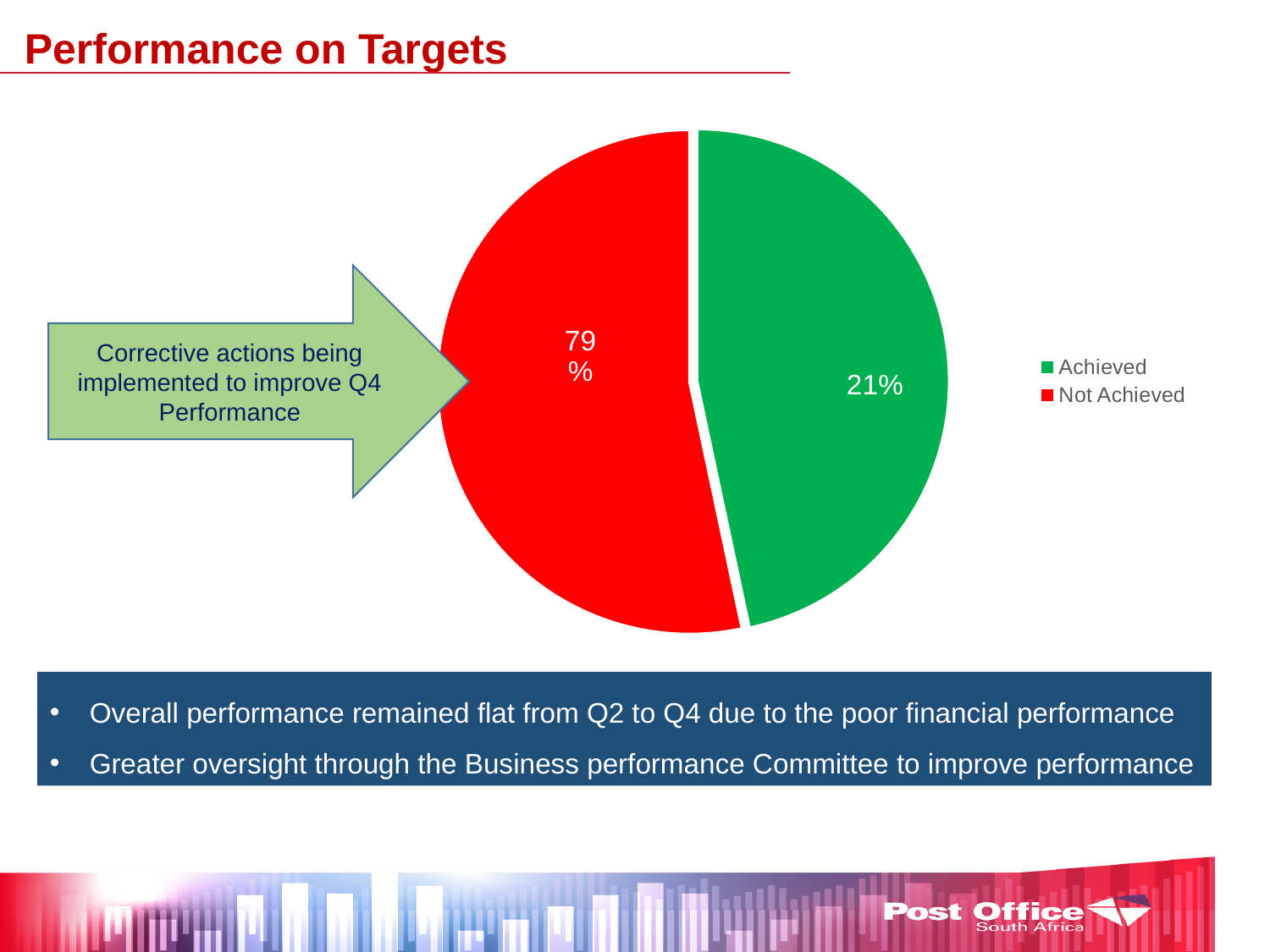
What is the difference in percentage points between Not Achieved and Achieved? 58 How many categories are shown in the pie chart? 2 What is the title of the slide containing the pie chart? Performance on Targets What type of chart is shown on the slide? pie chart What percentage of targets were not achieved according to the pie chart? 79% What percentage of targets were achieved according to the pie chart? 21% How many entries does the chart legend list? 2 Which category has the smaller share of the pie chart? Achieved What colour represents the Achieved category in the pie chart? green What share of the pie does the Not Achieved slice represent? 79% Which category has the larger share of the pie chart? Not Achieved Is the share for Achieved larger or smaller than the share for Not Achieved? smaller